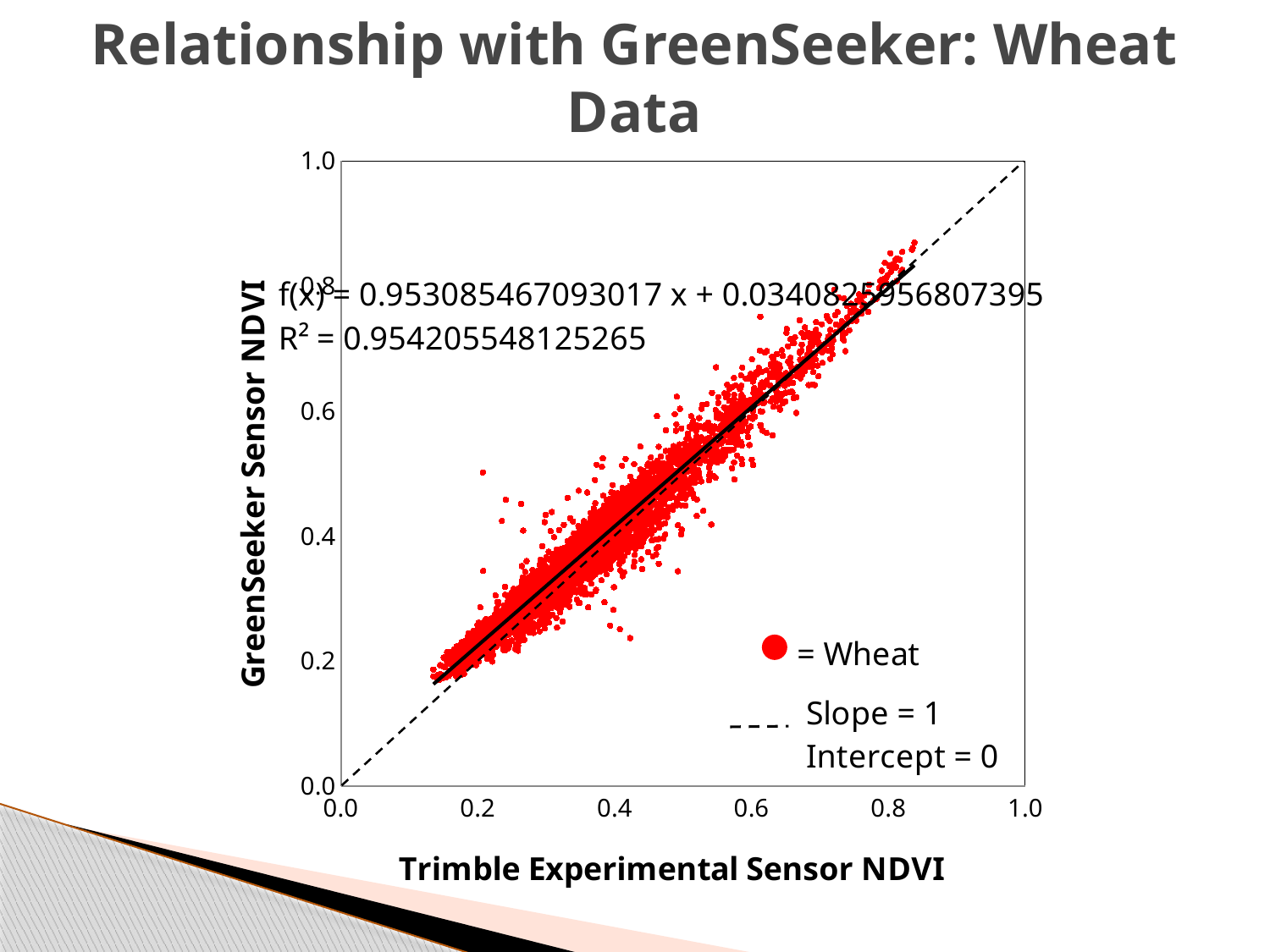
What crop do the red points represent according to the legend? Wheat What slope and intercept does the dashed reference line have according to the legend? Slope = 1, Intercept = 0 Do the GreenSeeker NDVI values rise or fall as the Trimble Experimental Sensor NDVI increases? rise What is the maximum value shown on the x axis? 1.0 What R² value is printed on the chart? 0.954205548125265 Is the R² value printed on the chart greater or less than 0.9? greater Is the slope of the fitted line f(x) greater or less than 1? less What is the label of the y axis? GreenSeeker Sensor NDVI What is the slope coefficient of the fitted line f(x) printed on the chart? 0.953085467093017 What is the title of the chart? Relationship with GreenSeeker: Wheat Data What kind of chart is shown on the slide? Scatter chart